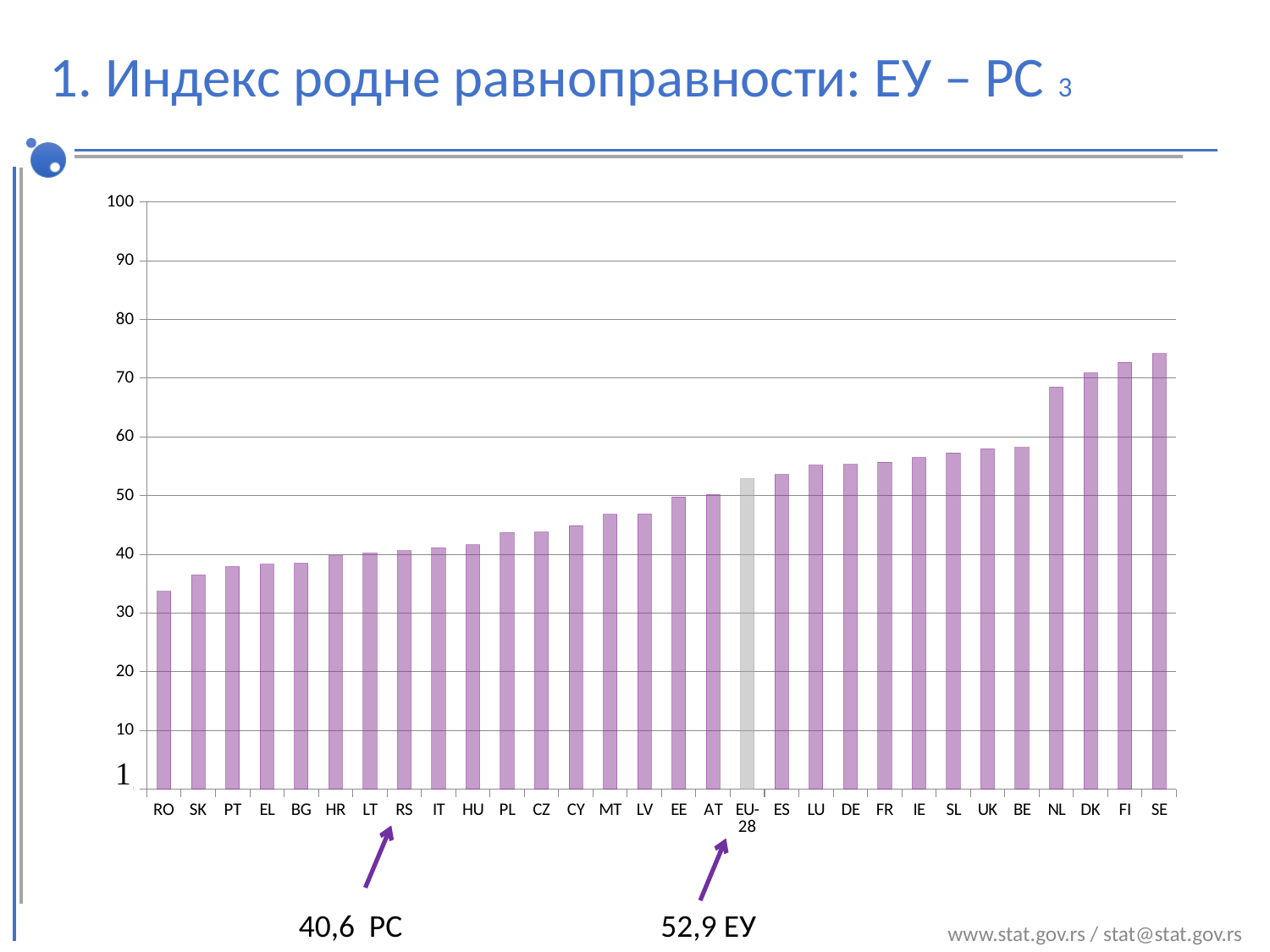
How many categories are shown on the x axis of the chart? 30 Is the value for RO greater or less than 40? less Which category has the lowest bar in the chart? RO What kind of chart is shown on the slide? bar chart What is the value for RS (РС) in the chart? 40,6 Is the value for SE greater or less than 70? greater Is the value for NL greater or less than 60? greater What is the value for EU-28 (ЕУ) in the chart? 52,9 Which category has the highest bar in the chart? SE Do the values rise or fall from left to right along the x axis? rise What is the difference between the EU-28 value and the RS value? 12,3 Which has a larger value, NL or HU? NL